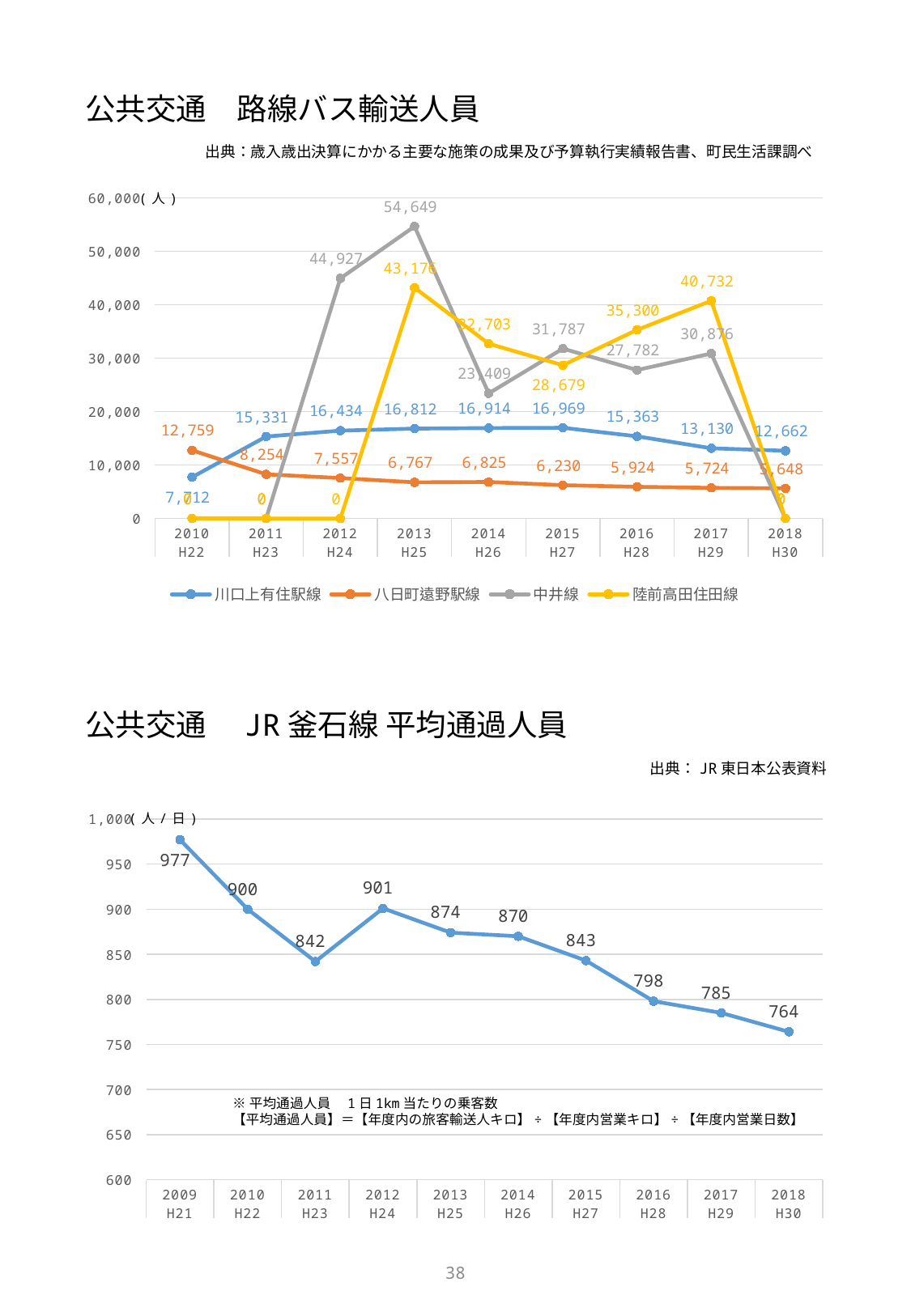
In the top chart (路線バス輸送人員), what is the value for 八日町遠野駅線 in 2010 (H22)? 12,759 In the top chart (路線バス輸送人員), which is larger in 2017 (H29): 陸前高田住田線 or 中井線? 陸前高田住田線 In the top chart (路線バス輸送人員), which series has the highest value in 2013 (H25)? 中井線 In the bottom chart (JR釜石線 平均通過人員), which year has the lowest value? 2018 (H30) In the top chart (路線バス輸送人員), how many series does the legend list? 4 In the top chart (路線バス輸送人員), what is the value for 中井線 in 2013 (H25)? 54,649 In the bottom chart (JR釜石線 平均通過人員), what is the difference between the 2009 (H21) value and the 2018 (H30) value? 213 What kind of chart is the bottom chart (JR釜石線 平均通過人員)? Line chart In the bottom chart (JR釜石線 平均通過人員), how many data points are plotted? 10 In the top chart (路線バス輸送人員), what is the value for 陸前高田住田線 in 2017 (H29)? 40,732 In the top chart (路線バス輸送人員), what is the difference between 川口上有住駅線 in 2015 (H27) and in 2018 (H30)? 4,307 In the bottom chart (JR釜石線 平均通過人員), what is the value for 2012 (H24)? 901